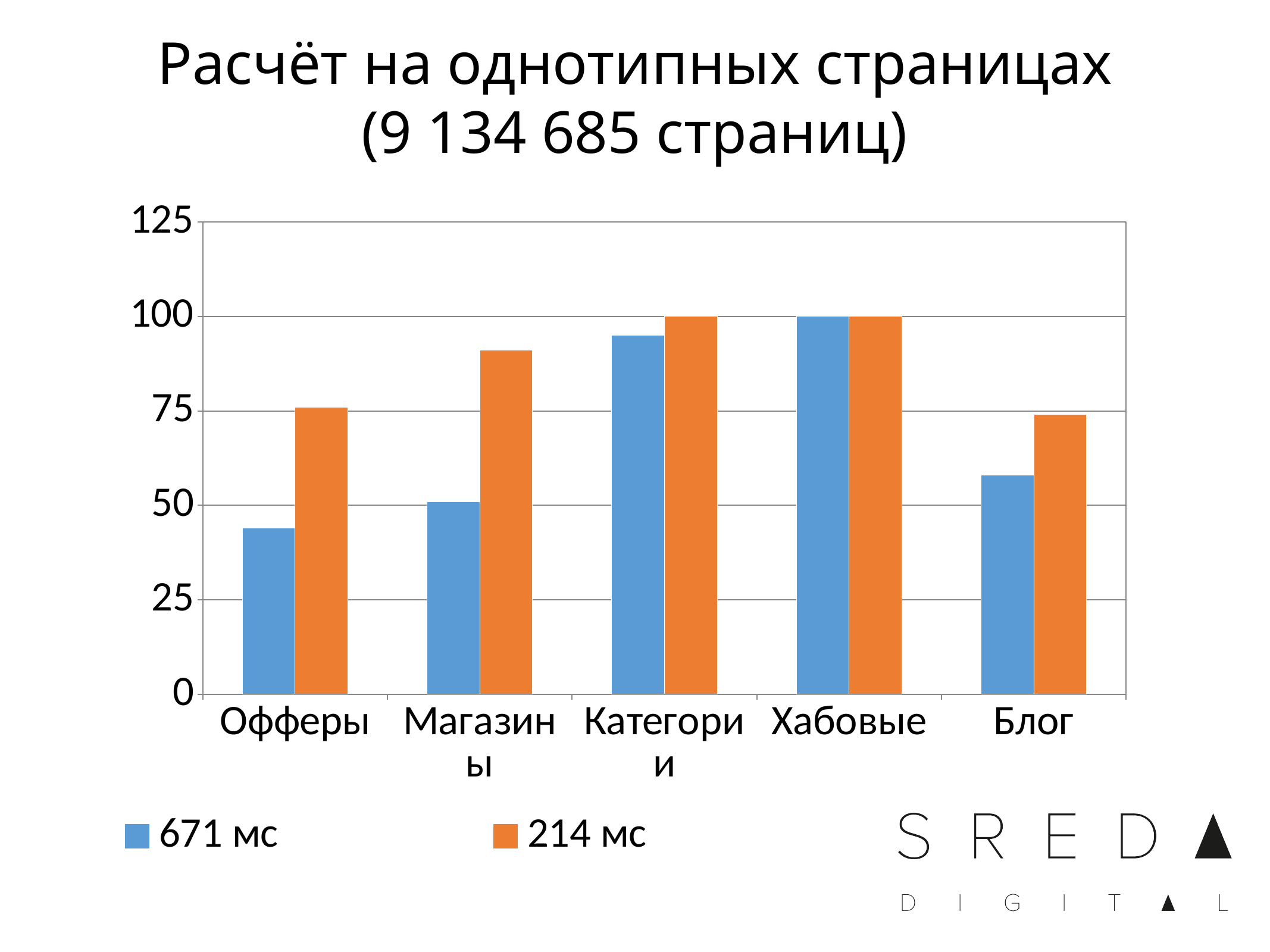
How many categories are shown on the x axis? 5 Which category has the highest value in the 671 мс series? Хабовые Is the value for Офферы in the 671 мс series greater or less than 50? less Is the value for Магазины in the 214 мс series greater or less than 75? greater What is the value for Категории in the 214 мс series? 100 Is the value for Блог in the 671 мс series greater or less than 50? greater What kind of chart is shown on the slide? bar chart What is the title of the chart? Расчёт на однотипных страницах (9 134 685 страниц) Which category has the lowest value in the 671 мс series? Офферы How many series does the legend list? 2 For Офферы, which series has the larger value, 671 мс or 214 мс? 214 мс What is the value for Хабовые in the 671 мс series? 100